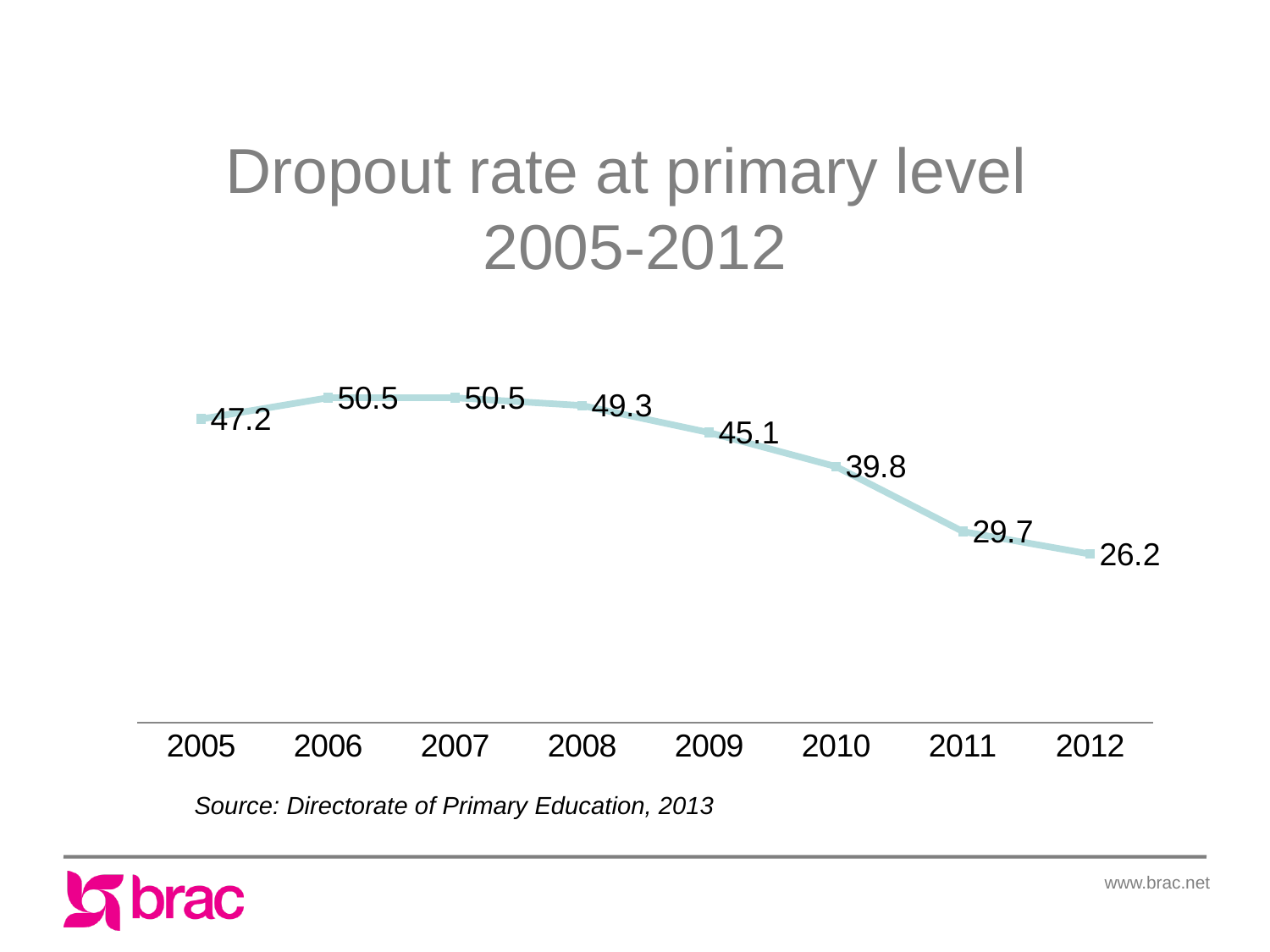
How many years are plotted on the chart? 8 What is the dropout rate at primary level in 2005? 47.2 What is the title of the chart? Dropout rate at primary level 2005-2012 What is the difference between the dropout rate in 2010 and in 2011? 10.1 What is the dropout rate at primary level in 2009? 45.1 Does the dropout rate rise or fall from 2007 to 2012? fall Is the dropout rate higher in 2008 or in 2010? 2008 What is the difference between the dropout rate in 2005 and in 2012? 21.0 Which year has the lowest dropout rate? 2012 What kind of chart is shown on the slide? line chart What is the dropout rate at primary level in 2012? 26.2 What is the dropout rate at primary level in 2011? 29.7